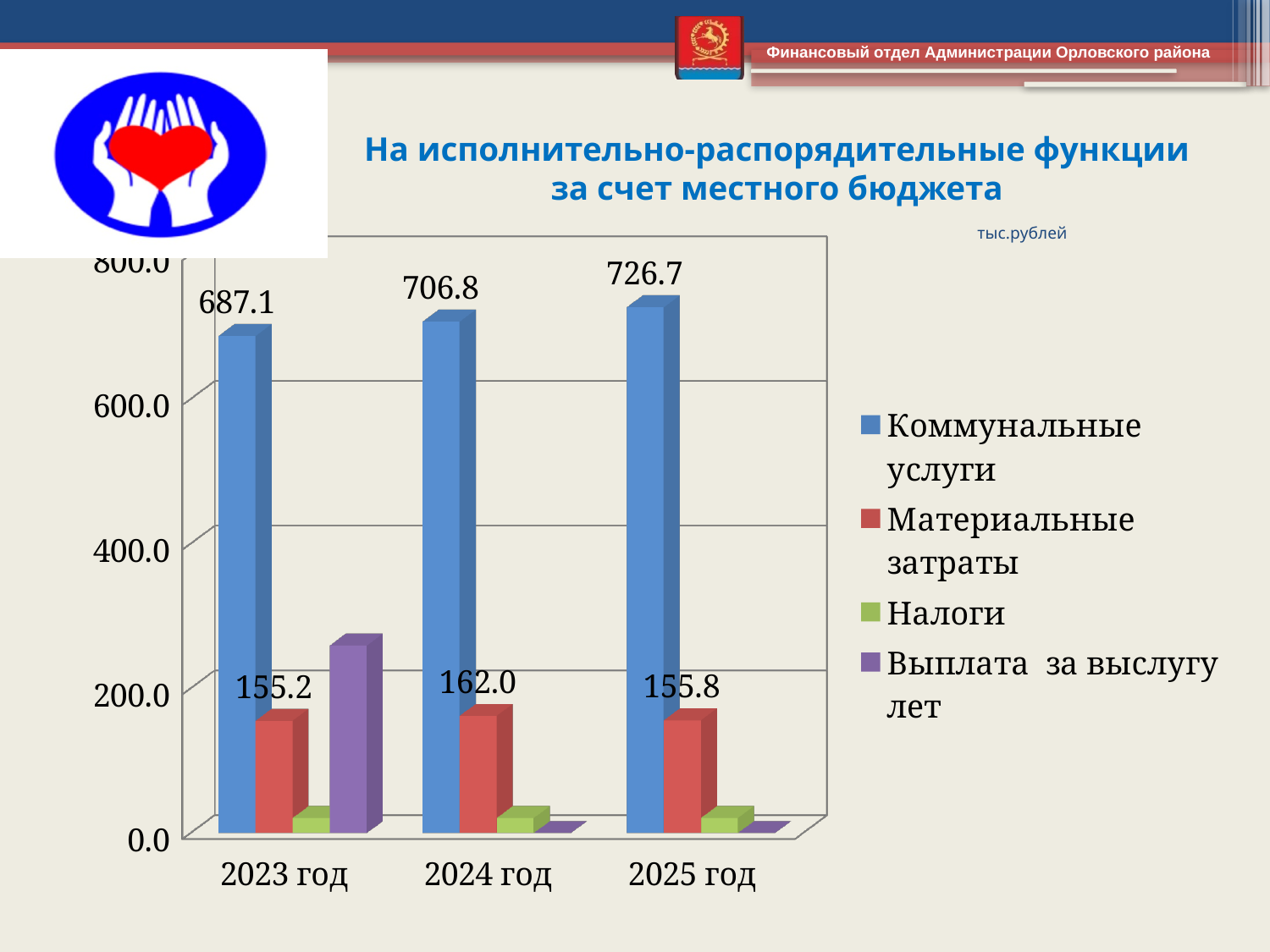
What is the value for Коммунальные услуги in 2023 год? 687.1 In which year is Коммунальные услуги highest? 2025 год In which year is Материальные затраты lowest? 2023 год How many series does the legend list? 4 What is the difference between Коммунальные услуги in 2025 год and 2023 год? 39.6 What is the value for Коммунальные услуги in 2025 год? 726.7 Which is larger: Коммунальные услуги in 2024 год or in 2023 год? 2024 год Do the values for Коммунальные услуги rise or fall from 2023 год to 2025 год? rise What is the value for Материальные затраты in 2025 год? 155.8 Is the value for Выплата за выслугу лет in 2023 год greater or less than 200? greater What is the value for Материальные затраты in 2024 год? 162.0 What kind of chart is shown on the slide? bar chart